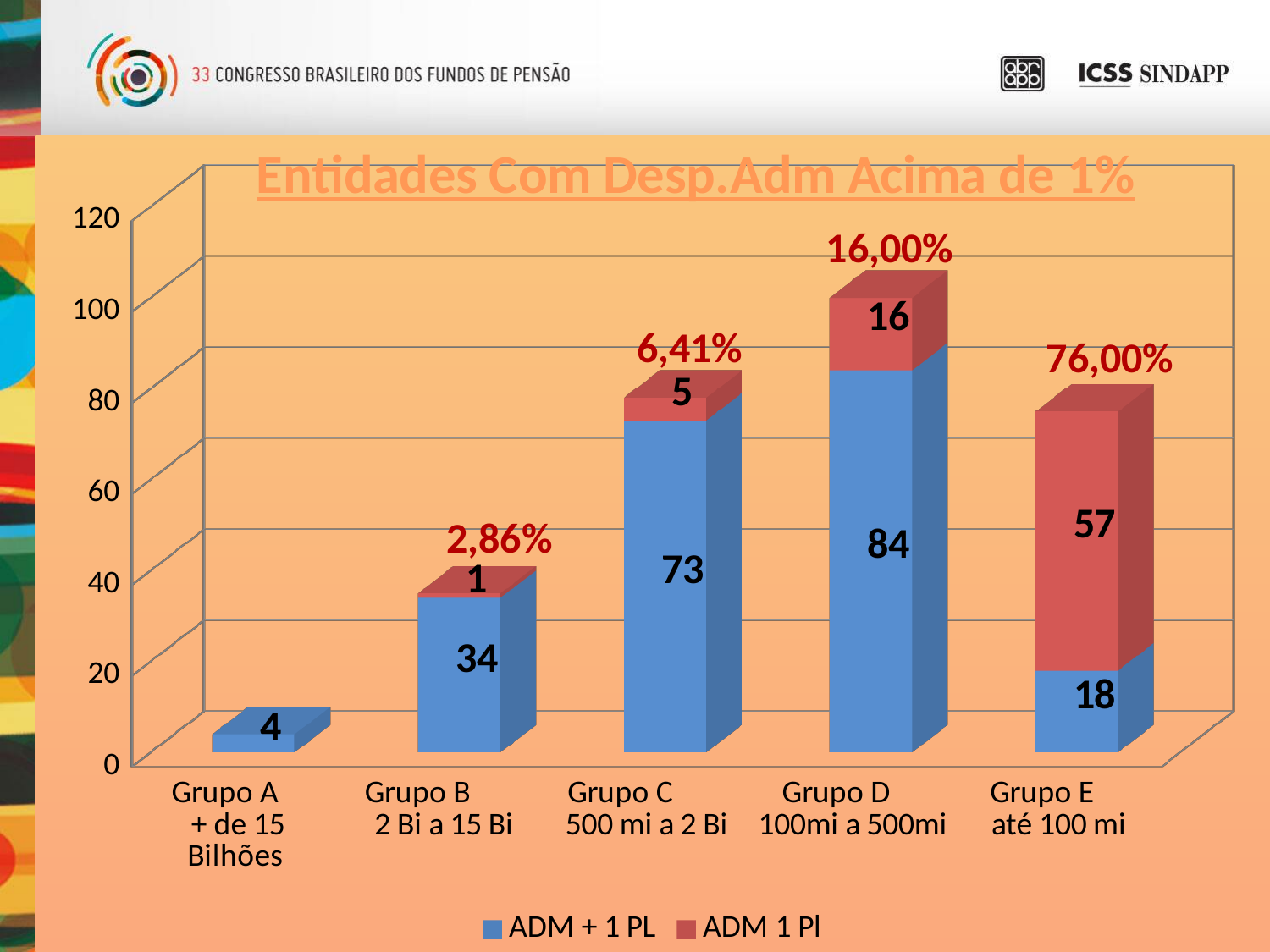
How many series does the legend list? 2 What percentage label is shown above the bar for Grupo C? 6,41% What is the value of the ADM 1 Pl series for Grupo E? 57 Which group has the lowest value for the ADM + 1 PL series? Grupo A How many groups are shown on the x axis? 5 What is the total of the stacked bar for Grupo D? 100 Which group has the highest value for the ADM + 1 PL series? Grupo D Which is larger for Grupo E: the ADM + 1 PL value or the ADM 1 Pl value? ADM 1 Pl What kind of chart is shown on the slide? Stacked bar chart What is the difference between the ADM + 1 PL values for Grupo C and Grupo B? 39 What is the value of the ADM + 1 PL series for Grupo B? 34 What is the value of the ADM + 1 PL series for Grupo D? 84